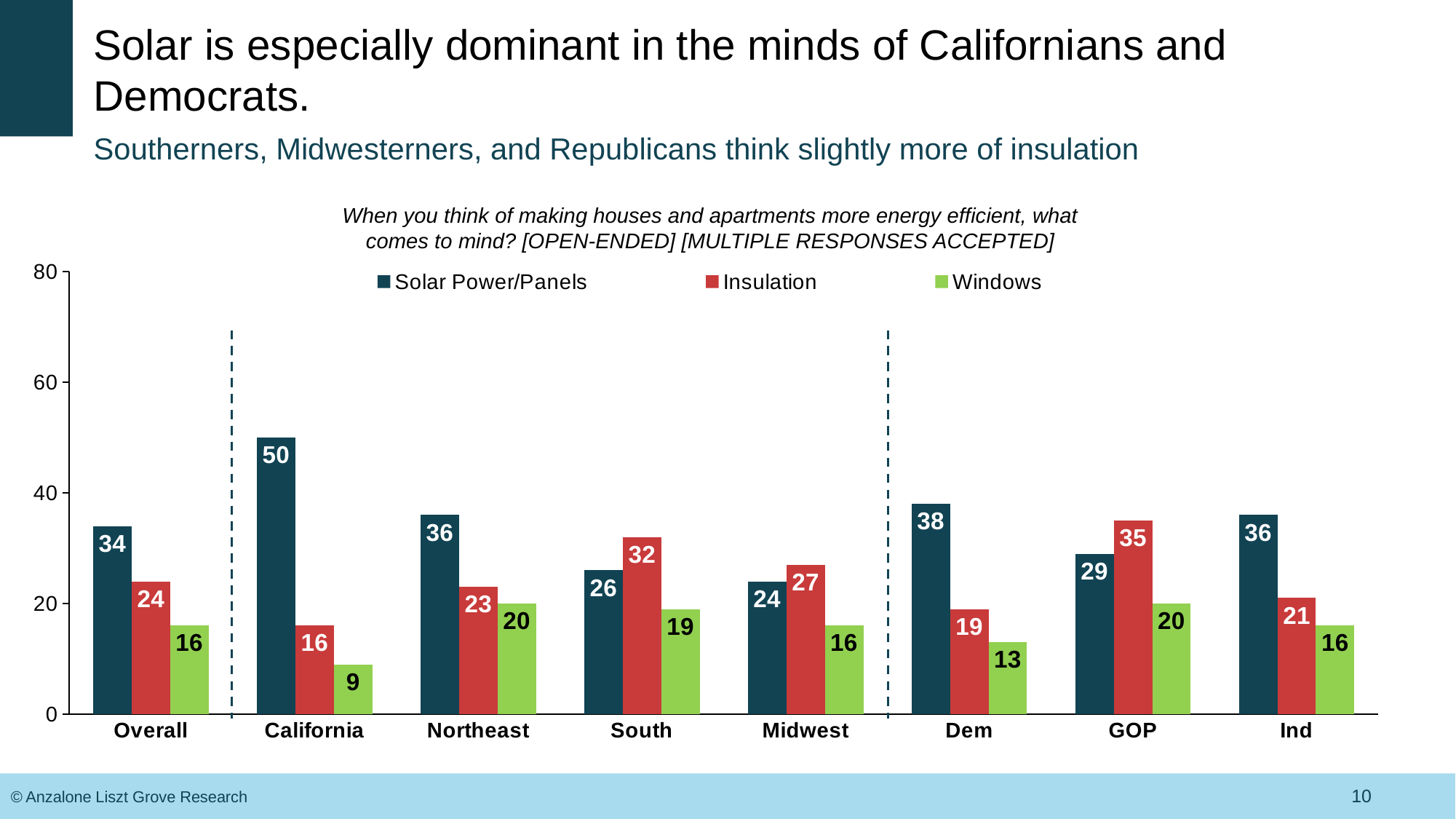
Which is larger in the South category, Solar Power/Panels or Insulation? Insulation What is the difference between the Solar Power/Panels and Insulation values for California? 34 How many series does the legend list? 3 Which series is shown in red in the legend? Insulation Which category has the lowest value for Windows? California What is the value for Solar Power/Panels in California? 50 What kind of chart is shown on the slide? bar chart Which category has the highest value for Solar Power/Panels? California What is the value for Insulation in the GOP category? 35 What is the value for Windows in the Dem category? 13 How many categories are shown on the x axis? 8 Is the value for Solar Power/Panels in the Dem category greater or less than 40? less